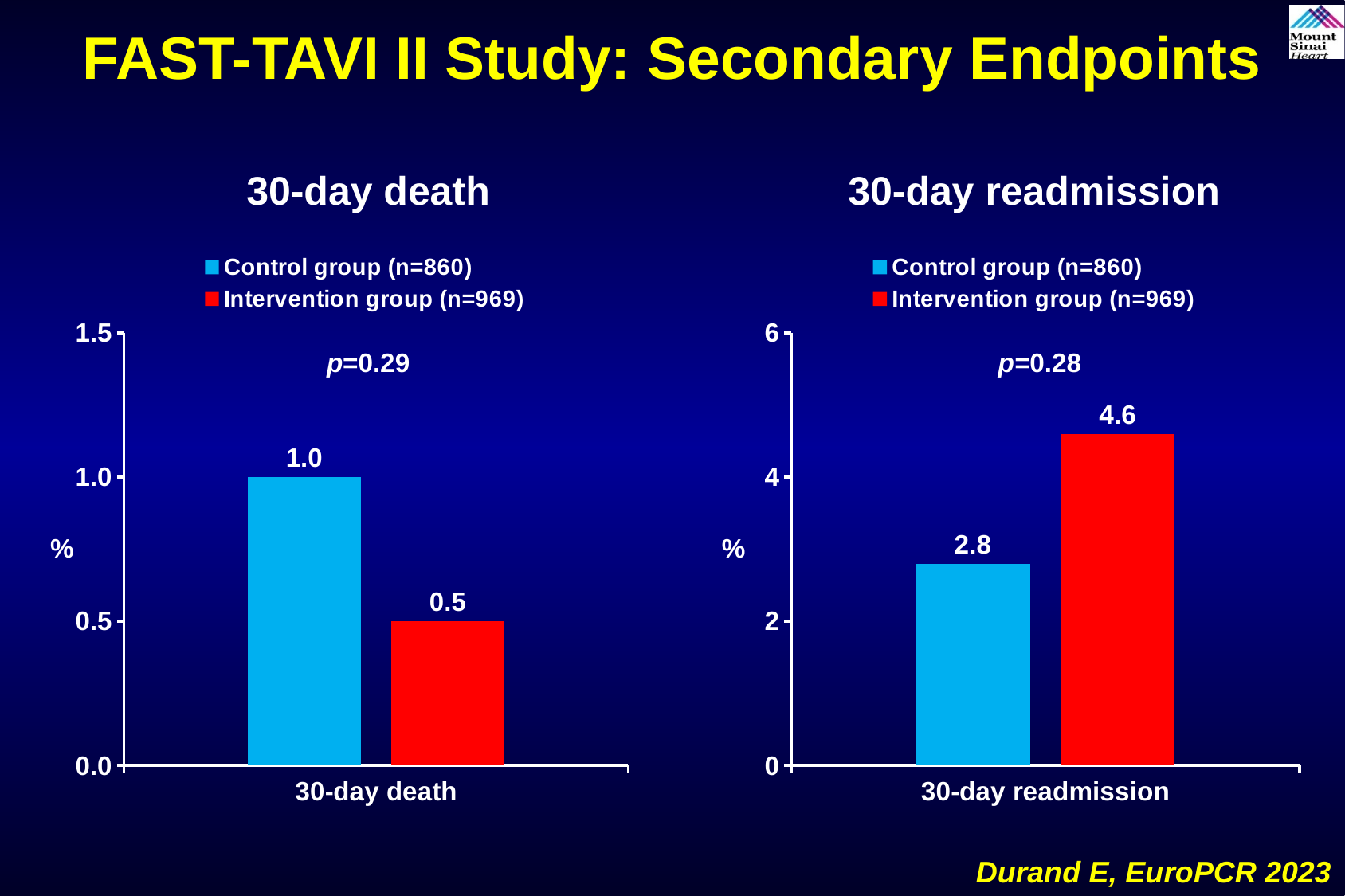
In the 30-day readmission chart, which group has the higher value? Intervention group (n=969) How many series does the legend of the 30-day readmission chart list? 2 In the 30-day readmission chart, what is the difference between the Intervention group and Control group values? 1.8 In the 30-day readmission chart, what is the value for the Control group (n=860)? 2.8 In the 30-day death chart, what is the value for the Control group (n=860)? 1.0 In the 30-day death chart, which group has the lower value? Intervention group (n=969) In the 30-day death chart, what is the value for the Intervention group (n=969)? 0.5 In the 30-day death chart, what is the difference between the Control group and Intervention group values? 0.5 In the 30-day death chart, is the Control group value larger or smaller than the Intervention group value? larger In the 30-day readmission chart, what is the value for the Intervention group (n=969)? 4.6 What p-value is shown on the 30-day readmission chart? p=0.28 What kind of chart is the 30-day death chart? bar chart